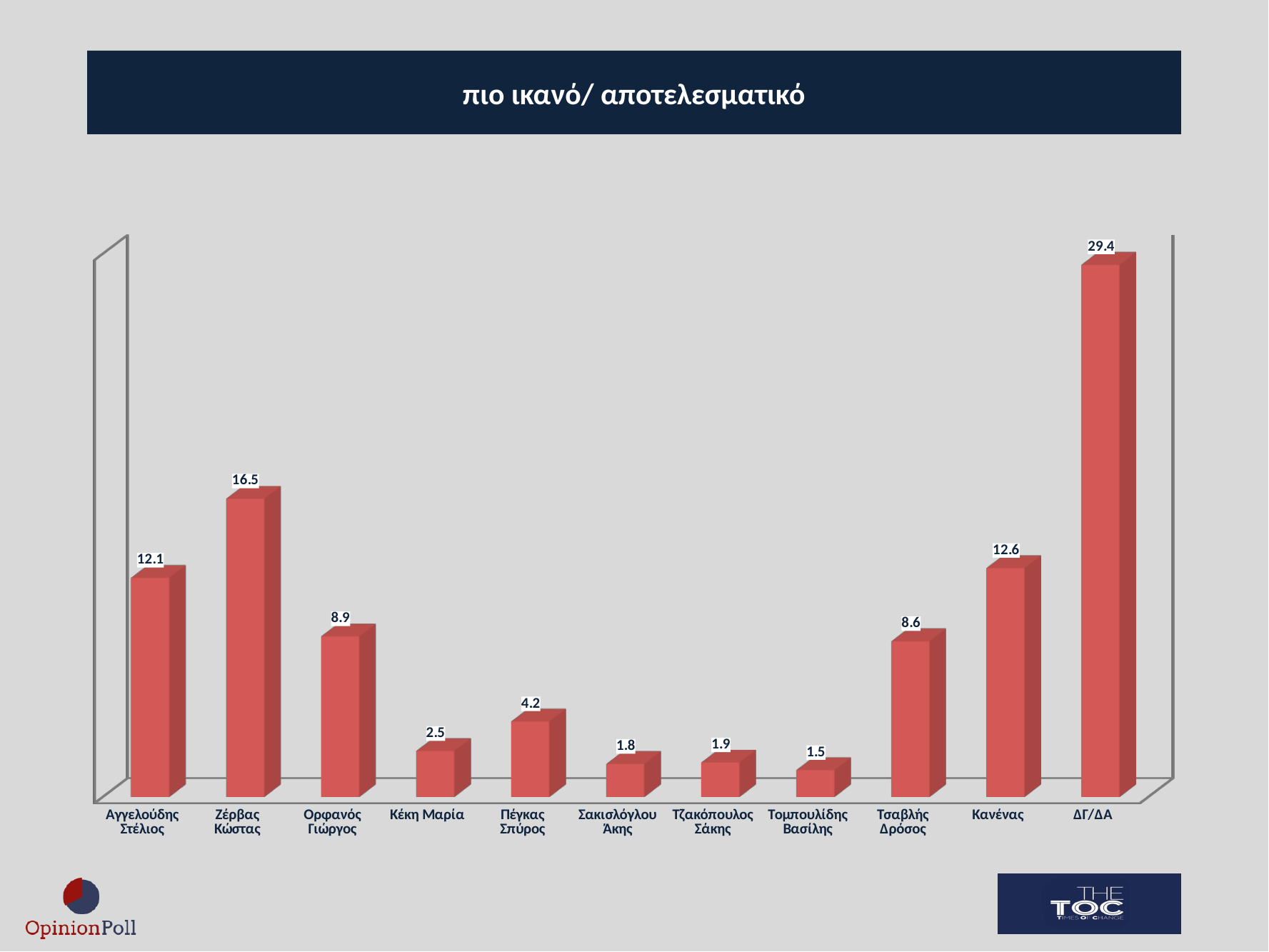
Which is larger, the value for Ορφανός Γιώργος or the value for Τσαβλής Δρόσος? Ορφανός Γιώργος Which category has the lowest value? Τομπουλίδης Βασίλης What is the value for Τσαβλής Δρόσος? 8.6 What is the value for Ζέρβας Κώστας? 16.5 Which is larger, the value for Κανένας or the value for Αγγελούδης Στέλιος? Κανένας What is the difference between the values for Ζέρβας Κώστας and Αγγελούδης Στέλιος? 4.4 What kind of chart is shown on the slide? bar chart What is the value for Κανένας? 12.6 How many categories are shown on the x axis? 11 Which category has the highest value? ΔΓ/ΔΑ What is the value for ΔΓ/ΔΑ? 29.4 What is the title of the chart? πιο ικανό/ αποτελεσματικό